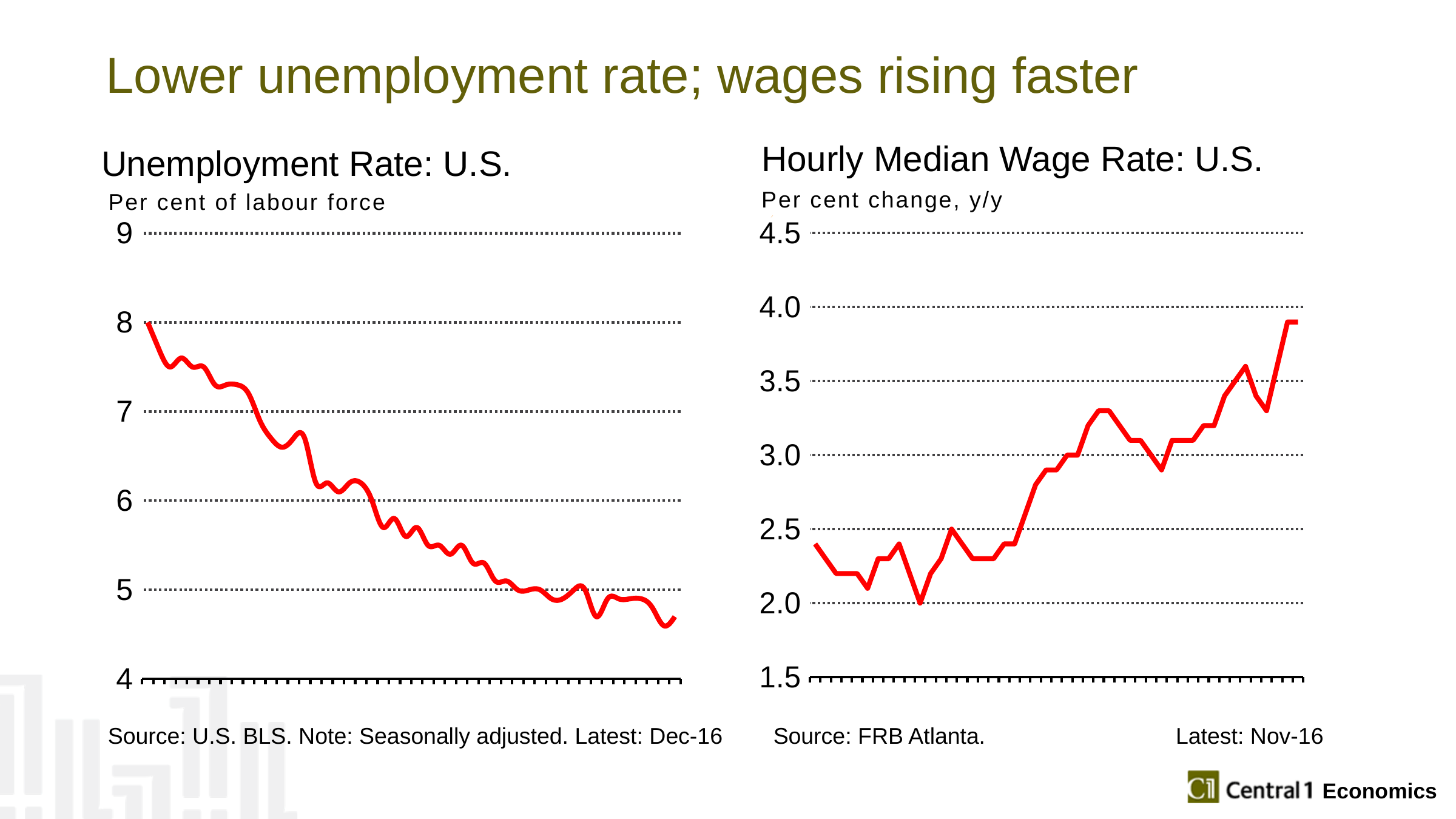
In the Hourly Median Wage Rate: U.S. chart, do the values rise or fall overall from left to right along the x axis? rise What is the source given for the Hourly Median Wage Rate: U.S. chart? FRB Atlanta In the Hourly Median Wage Rate: U.S. chart, is the first value on the left greater or less than 3.0? less In the Hourly Median Wage Rate: U.S. chart, is the lowest point on the line greater or less than 2.5? less In the Unemployment Rate: U.S. chart, is the first value on the left greater or less than 7? greater What kind of chart is the Hourly Median Wage Rate: U.S. chart? line chart How many charts are shown on the slide? 2 What is the y-axis label of the Unemployment Rate: U.S. chart? Per cent of labour force What kind of chart is the Unemployment Rate: U.S. chart? line chart In the Unemployment Rate: U.S. chart, do the values rise or fall from left to right along the x axis? fall